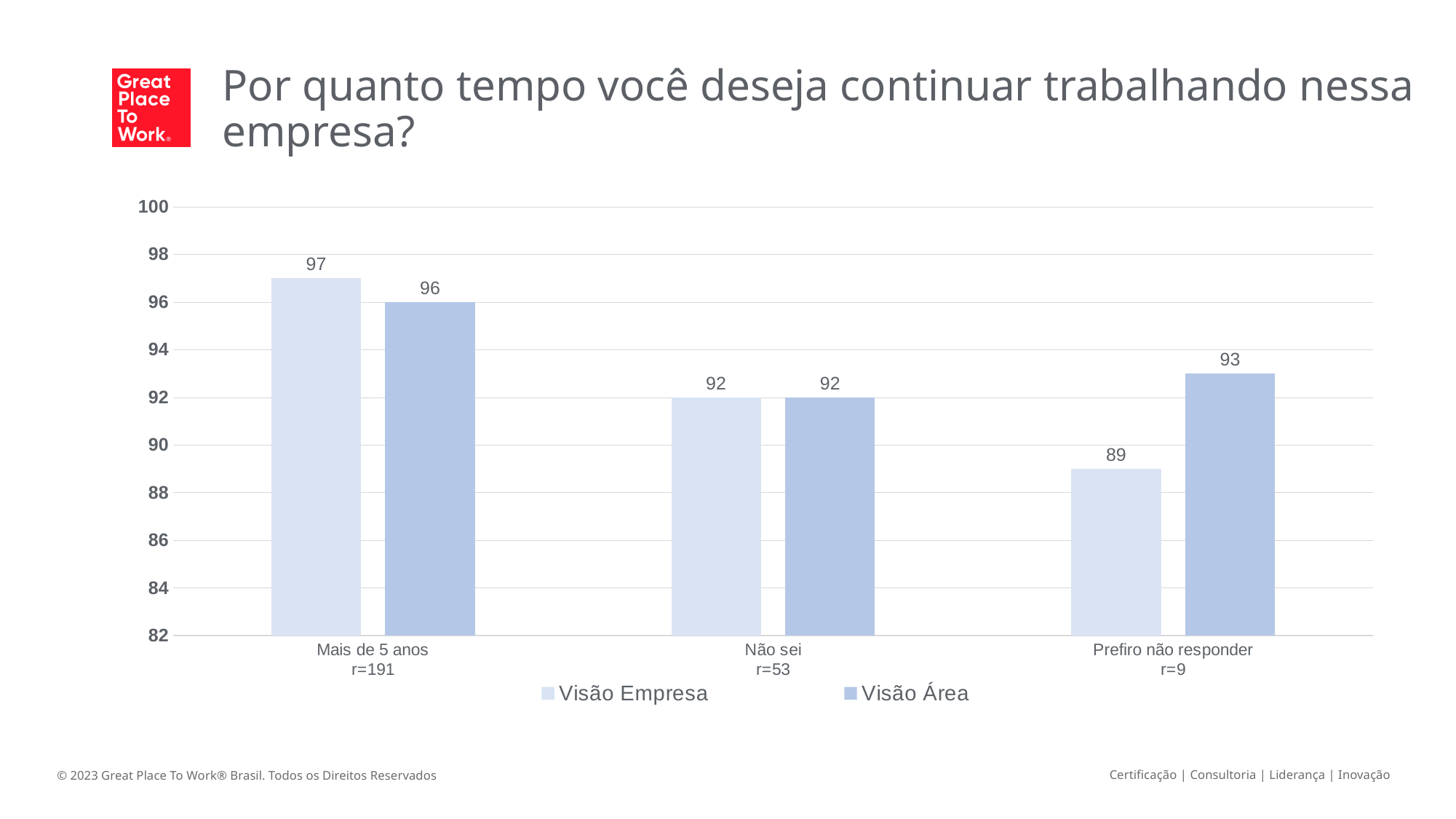
What is the number of respondents (r) shown for 'Não sei'? r=53 Which category has the lowest Visão Empresa value? Prefiro não responder What kind of chart is shown on the slide? Bar chart Which category has the highest Visão Empresa value? Mais de 5 anos What is the Visão Empresa value for 'Mais de 5 anos'? 97 What is the difference between the Visão Empresa values for 'Mais de 5 anos' and 'Não sei'? 5 How many series does the legend list? 2 What is the difference between the Visão Empresa and Visão Área values for 'Prefiro não responder'? 4 Which is larger for 'Mais de 5 anos': Visão Empresa or Visão Área? Visão Empresa What is the Visão Área value for 'Prefiro não responder'? 93 How many categories are shown on the x axis? 3 What is the Visão Área value for 'Não sei'? 92